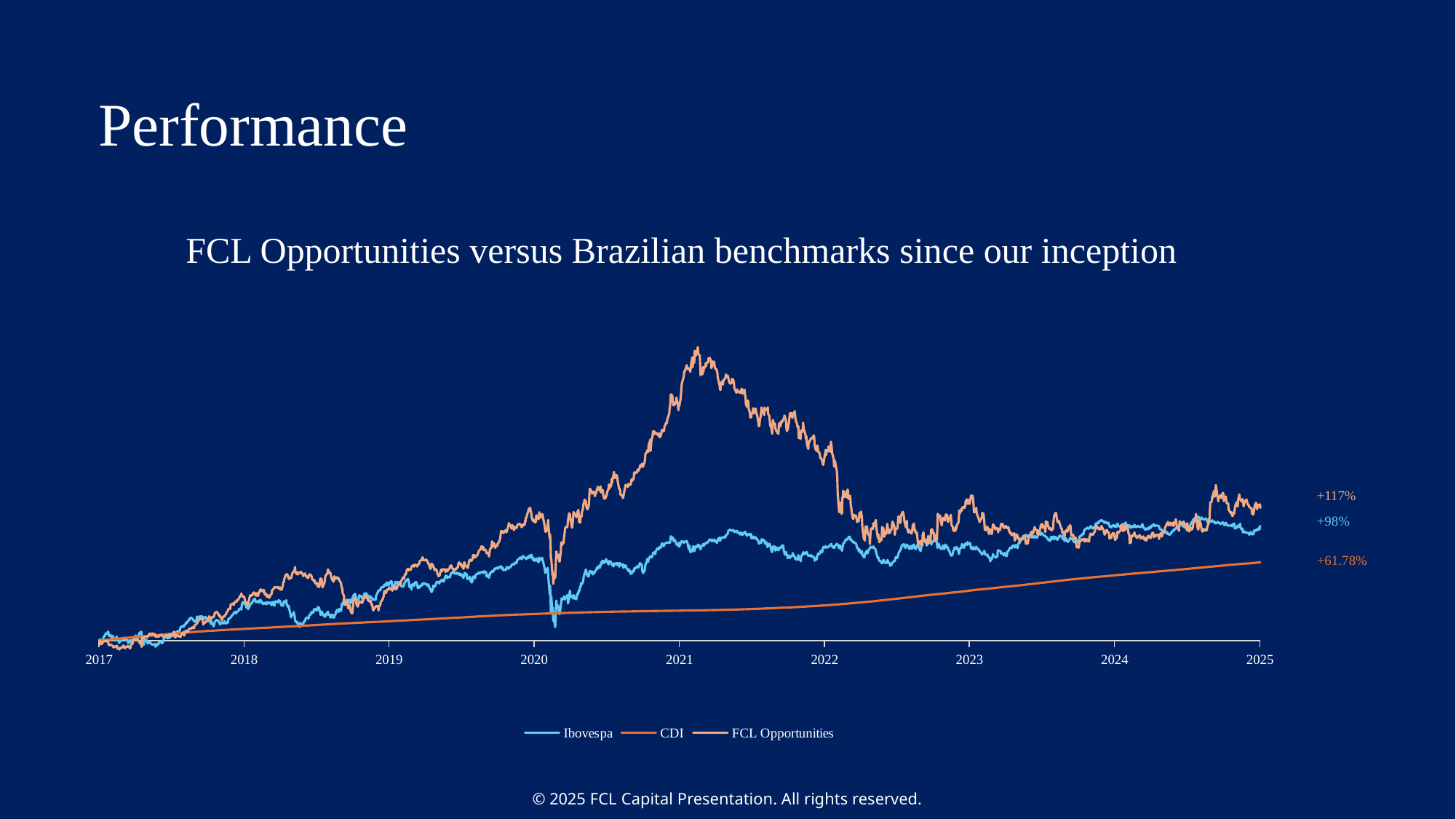
Which series has the highest cumulative return at the end of the chart? FCL Opportunities What kind of chart is shown on the slide? line chart What is the first year shown on the x axis? 2017 What is the last year shown on the x axis? 2025 How many series does the legend list? 3 What is the cumulative return shown for FCL Opportunities at the end of the chart? +117% Does the CDI line rise or fall from 2017 to 2025? rise Which series has the lowest cumulative return at the end of the chart? CDI What is the difference between the end-of-chart returns of FCL Opportunities and Ibovespa? 19 percentage points What is the cumulative return shown for Ibovespa at the end of the chart? +98% Which is larger at the end of the chart, the return for Ibovespa or the return for CDI? Ibovespa What is the cumulative return shown for CDI at the end of the chart? +61.78%